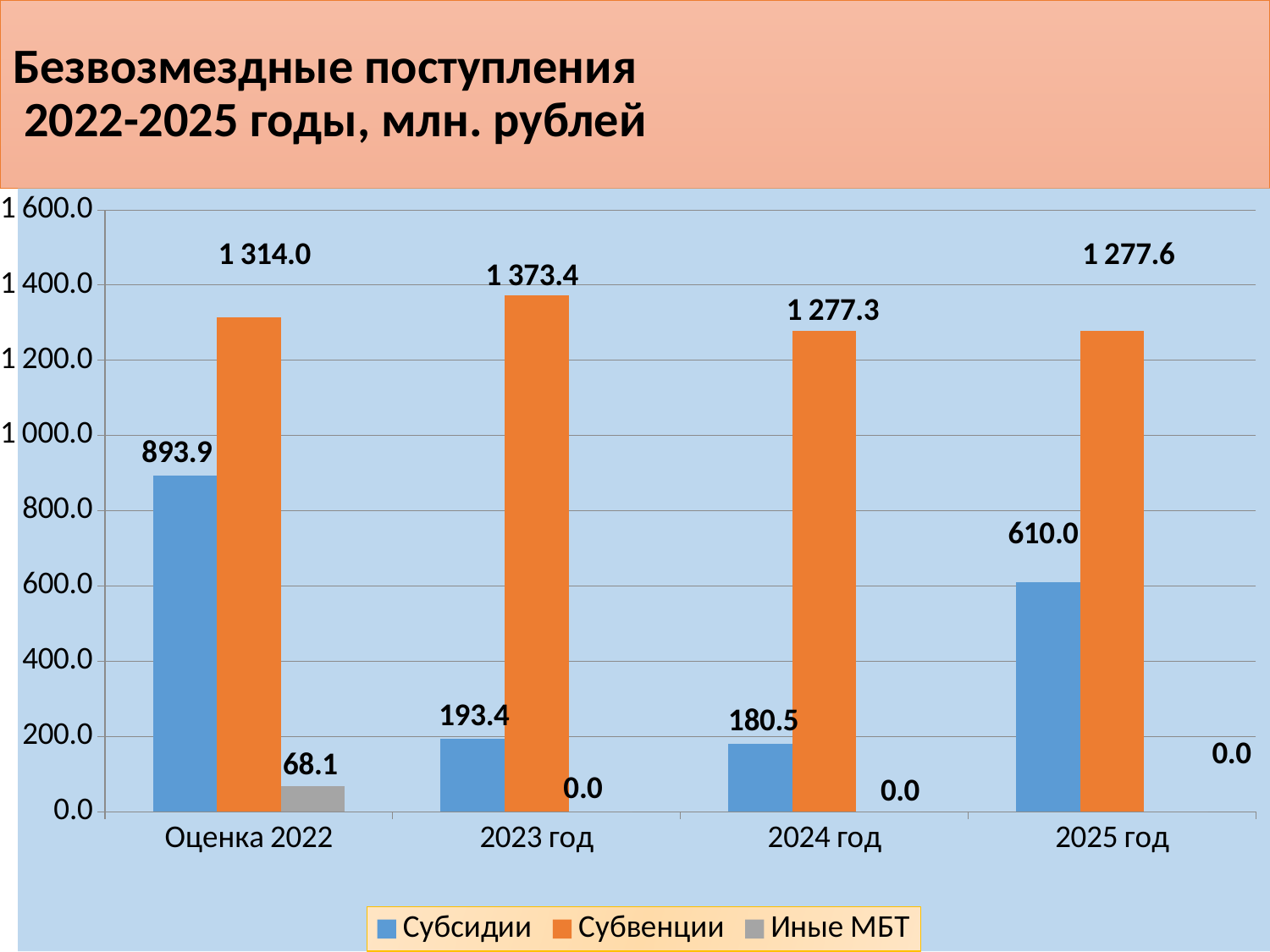
What kind of chart is shown on the slide? bar chart What is the value of Иные МБТ for Оценка 2022? 68.1 In which category is Субсидии lowest? 2024 год What is the value of Субсидии for Оценка 2022? 893.9 What is the value of Субвенции for 2023 год? 1 373.4 In which category is Субвенции highest? 2023 год How many categories are shown on the x axis? 4 What is the title of the slide? Безвозмездные поступления 2022-2025 годы, млн. рублей How many series does the legend list? 3 What is the difference between Субсидии for Оценка 2022 and Субсидии for 2025 год? 283.9 Which is larger: Субвенции for Оценка 2022 or Субвенции for 2024 год? Оценка 2022 What is the value of Субсидии for 2025 год? 610.0